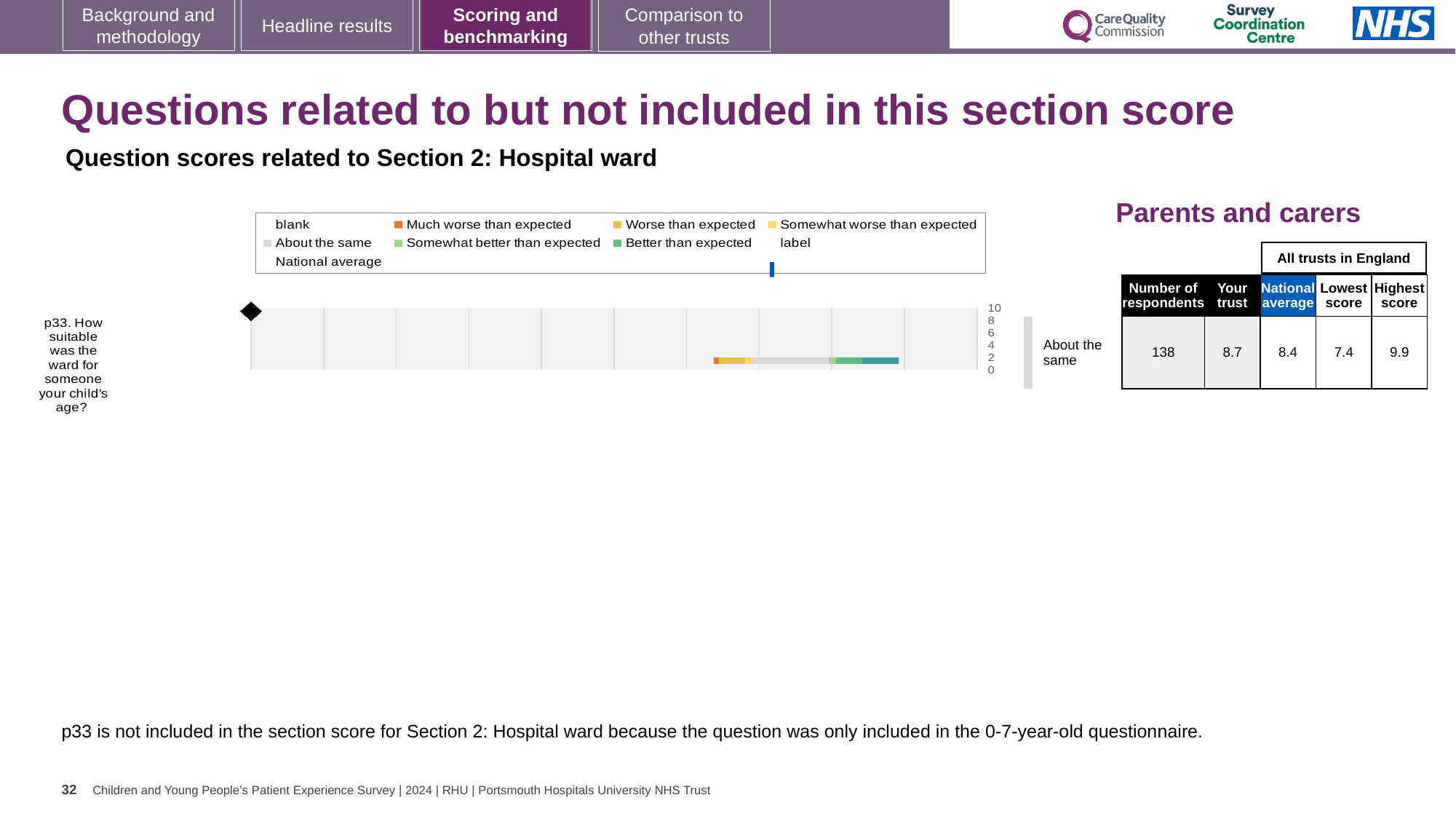
In the table beside the chart, what is the 'Your trust' score for p33? 8.7 What is the text of the question plotted in the chart? p33. How suitable was the ward for someone your child's age? Which is larger for p33: the 'Your trust' score or the national average? Your trust In the table beside the chart, what is the number of respondents for p33? 138 What kind of chart is used to show the p33 question score? bar chart In the table beside the chart, what is the lowest score among all trusts in England for p33? 7.4 What is the highest value shown on the chart's score axis? 10 What benchmark category label is shown to the right of the p33 bar? About the same How many questions (categories) are plotted in the chart? 1 In the table beside the chart, what is the highest score among all trusts in England for p33? 9.9 What is the difference between the highest score and the lowest score for p33 in the table beside the chart? 2.5 In the table beside the chart, what is the national average score for p33? 8.4